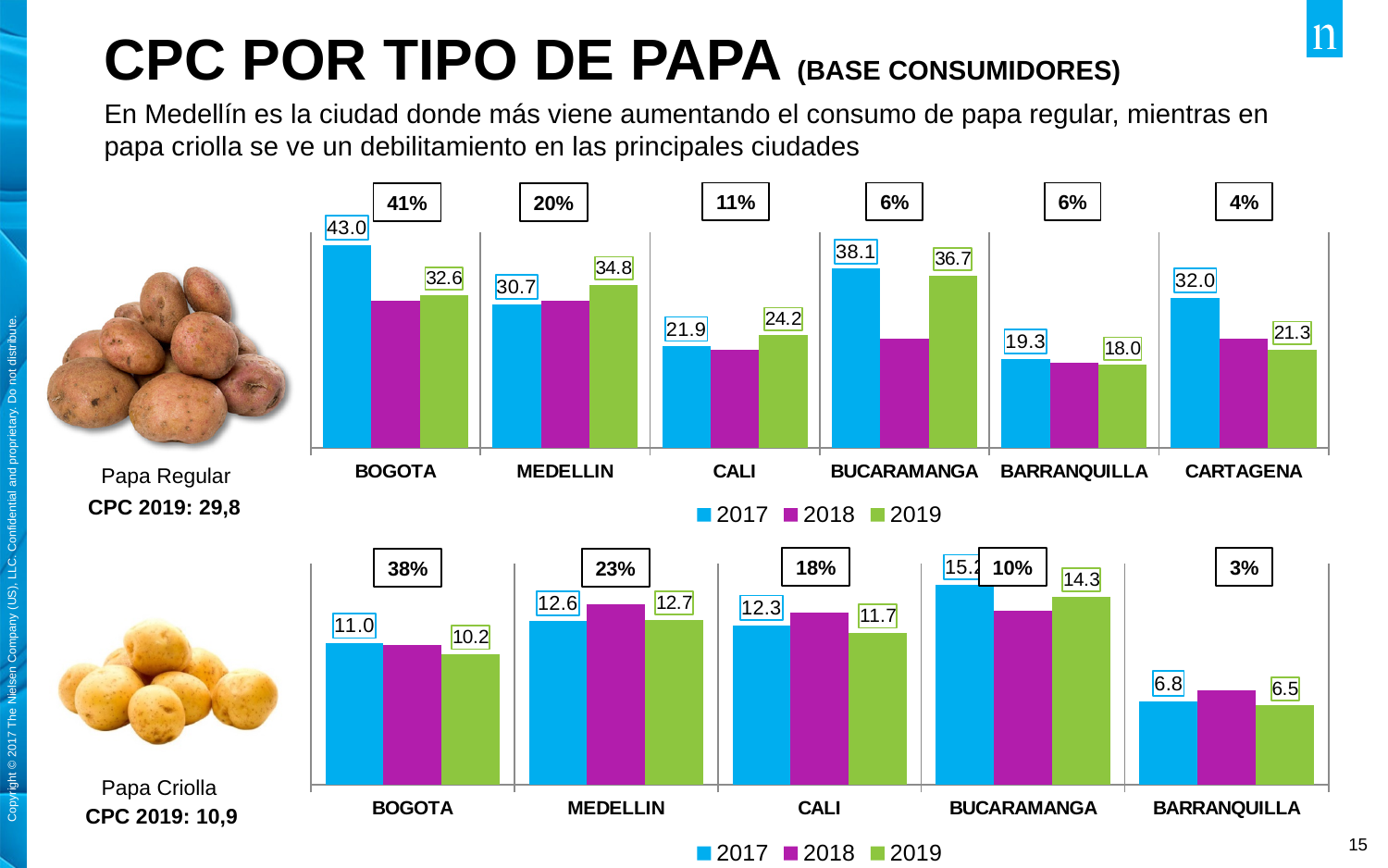
In the Papa Criolla chart (bottom), what is the 2019 value for BUCARAMANGA? 14.3 In the Papa Regular chart (top), what is the 2017 value for BOGOTA? 43.0 In the Papa Regular chart (top), which city has the highest 2017 value? BOGOTA In the Papa Criolla chart (bottom), how many series does the legend list? 3 What type of chart is the Papa Criolla chart (bottom)? Bar chart In the Papa Criolla chart (bottom), which is larger for CALI: the 2017 value or the 2019 value? 2017 In the Papa Criolla chart (bottom), how many cities are shown? 5 In the Papa Criolla chart (bottom), what is the 2017 value for BARRANQUILLA? 6.8 In the Papa Regular chart (top), how many cities are shown? 6 In the Papa Regular chart (top), what is the 2019 value for MEDELLIN? 34.8 In the Papa Regular chart (top), what is the difference between the 2017 and 2019 values for CARTAGENA? 10.7 In the Papa Regular chart (top), which city has the lowest 2019 value? BARRANQUILLA